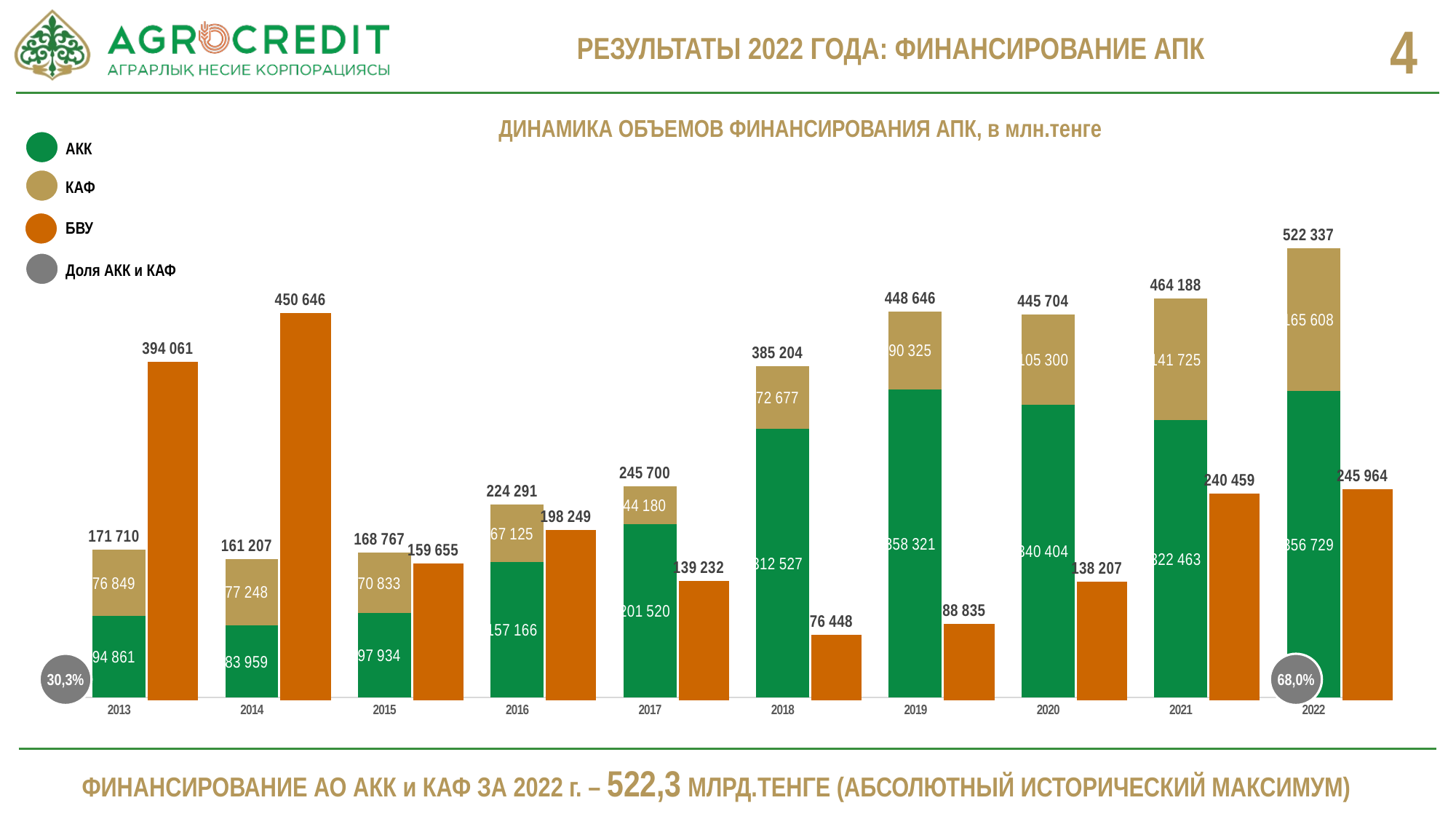
In which year is the БВУ bar the highest? 2014 In 2013, which is larger: the combined АКК and КАФ bar or the БВУ bar? БВУ What is the АКК value for 2022? 356 729 How many years are shown on the x axis? 10 Do the КАФ values rise or fall from 2018 to 2022? Rise What share is shown in the grey circle for 2022 (Доля АКК и КАФ)? 68,0% How many entries does the legend list? 4 In which year is the БВУ bar the lowest? 2018 What type of chart is shown on the slide? Bar chart What is the difference between the АКК+КАФ total for 2022 and the total for 2021? 58 149 What is the total of the stacked АКК and КАФ bar for 2019? 448 646 What is the value of the БВУ bar for 2014? 450 646